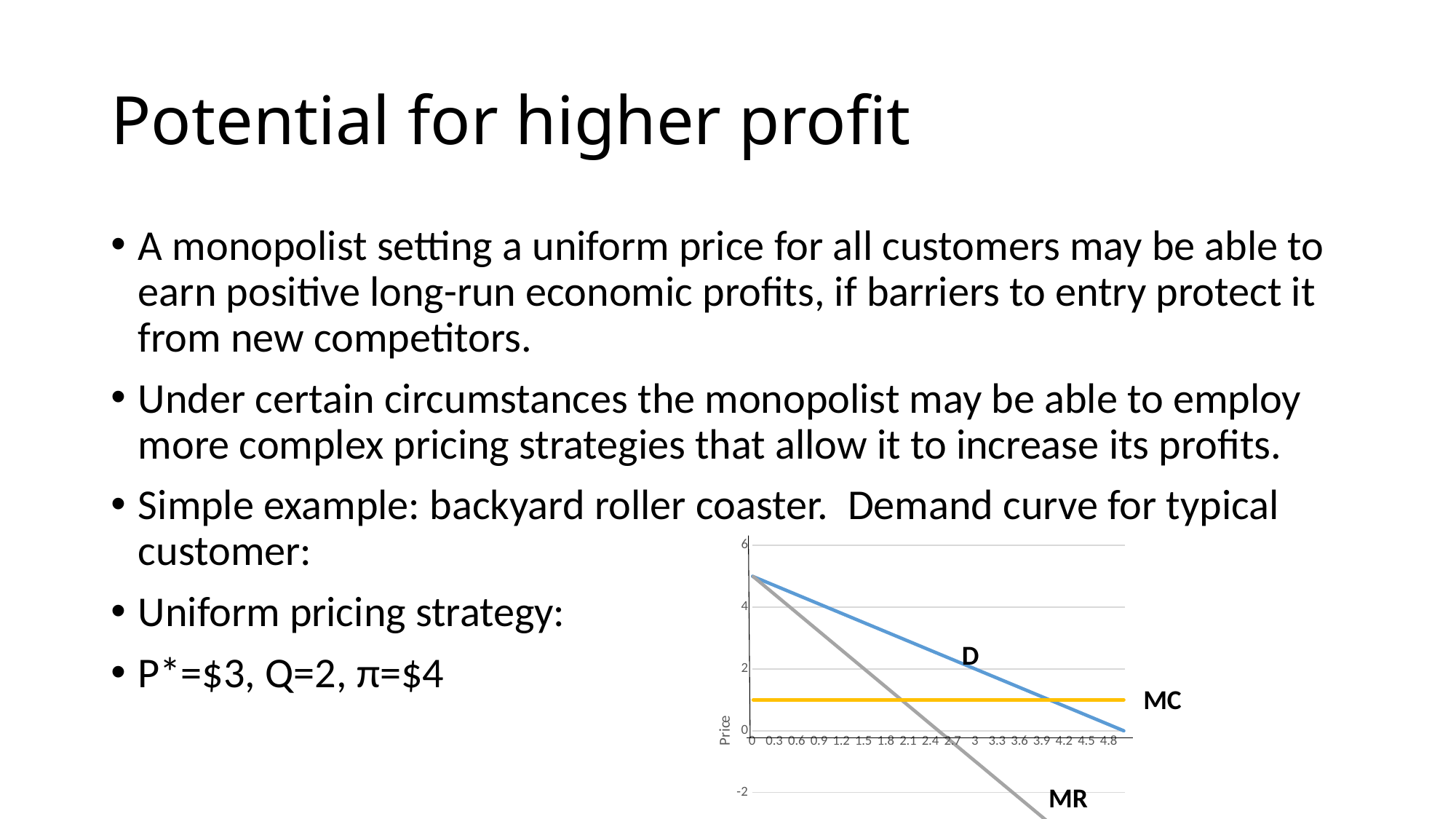
Is the value of the D line at quantity 1.5 greater or less than 2? greater Is the value of the MC line greater or less than 2? less Which line on the chart is horizontal (flat)? MC What is the label of the vertical axis of the chart? Price Does the MR line rise or fall as quantity increases along the x axis? fall At quantity 3, which line is higher, D or MR? D Is the value of the D line at quantity 0 greater or less than 4? greater Does the D line rise or fall as quantity increases along the x axis? fall At quantity 3.9, which line is lowest on the chart? MR What kind of chart is shown on the slide? line chart How many lines are plotted on the chart? 3